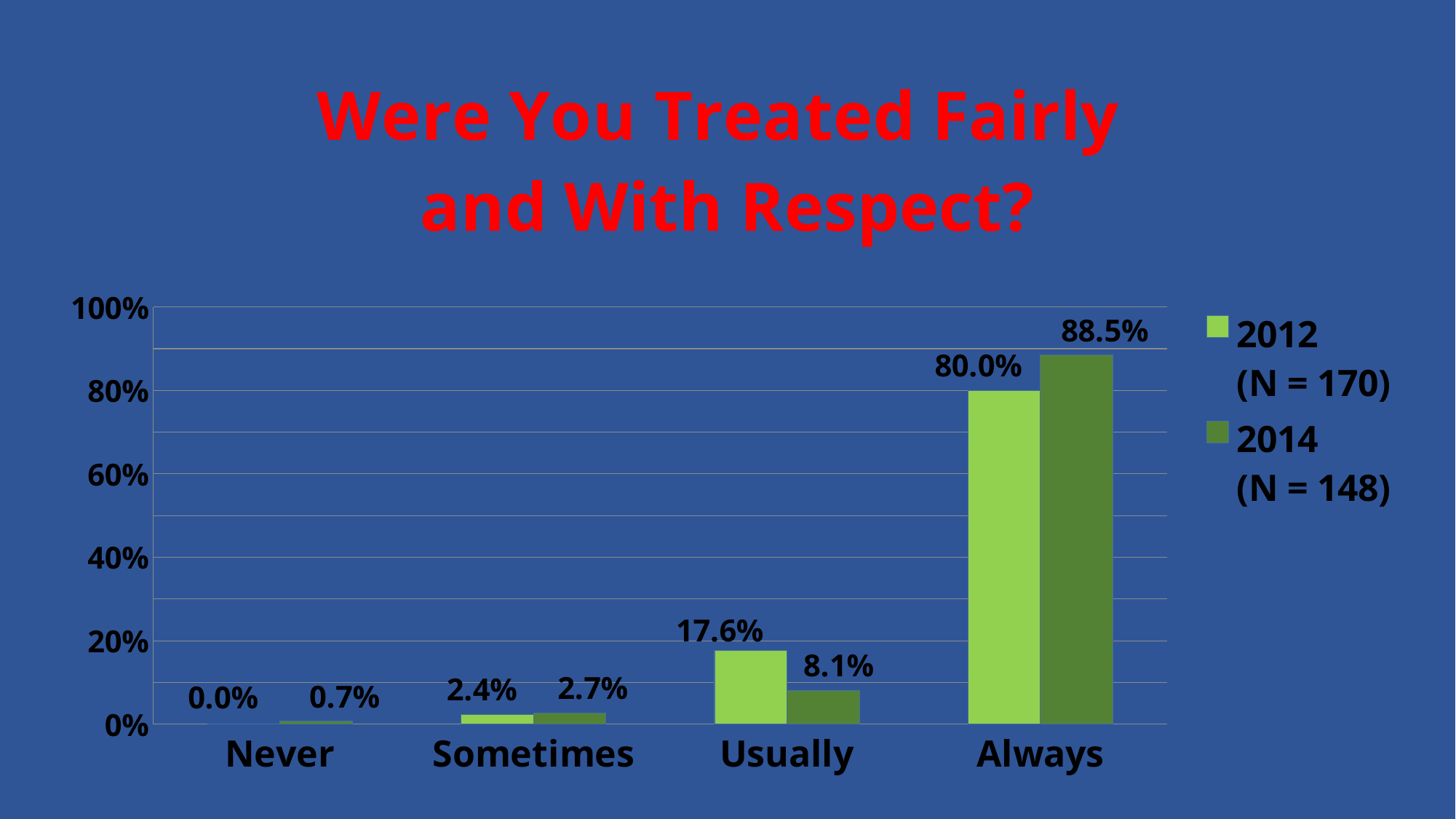
What is the difference between the 2014 and 2012 values for Always? 8.5% What is the difference between the 2012 and 2014 values for Usually? 9.5% What is the 2014 value for Always? 88.5% Which category has the highest 2012 value? Always How many categories are shown on the x axis? 4 What is the 2014 value for Sometimes? 2.7% How many series does the legend list? 2 What is the 2012 value for Never? 0.0% What kind of chart is shown on the slide? Bar chart What is the 2012 value for Usually? 17.6% Which is larger for Usually, the 2012 value or the 2014 value? 2012 Which category has the lowest 2014 value? Never